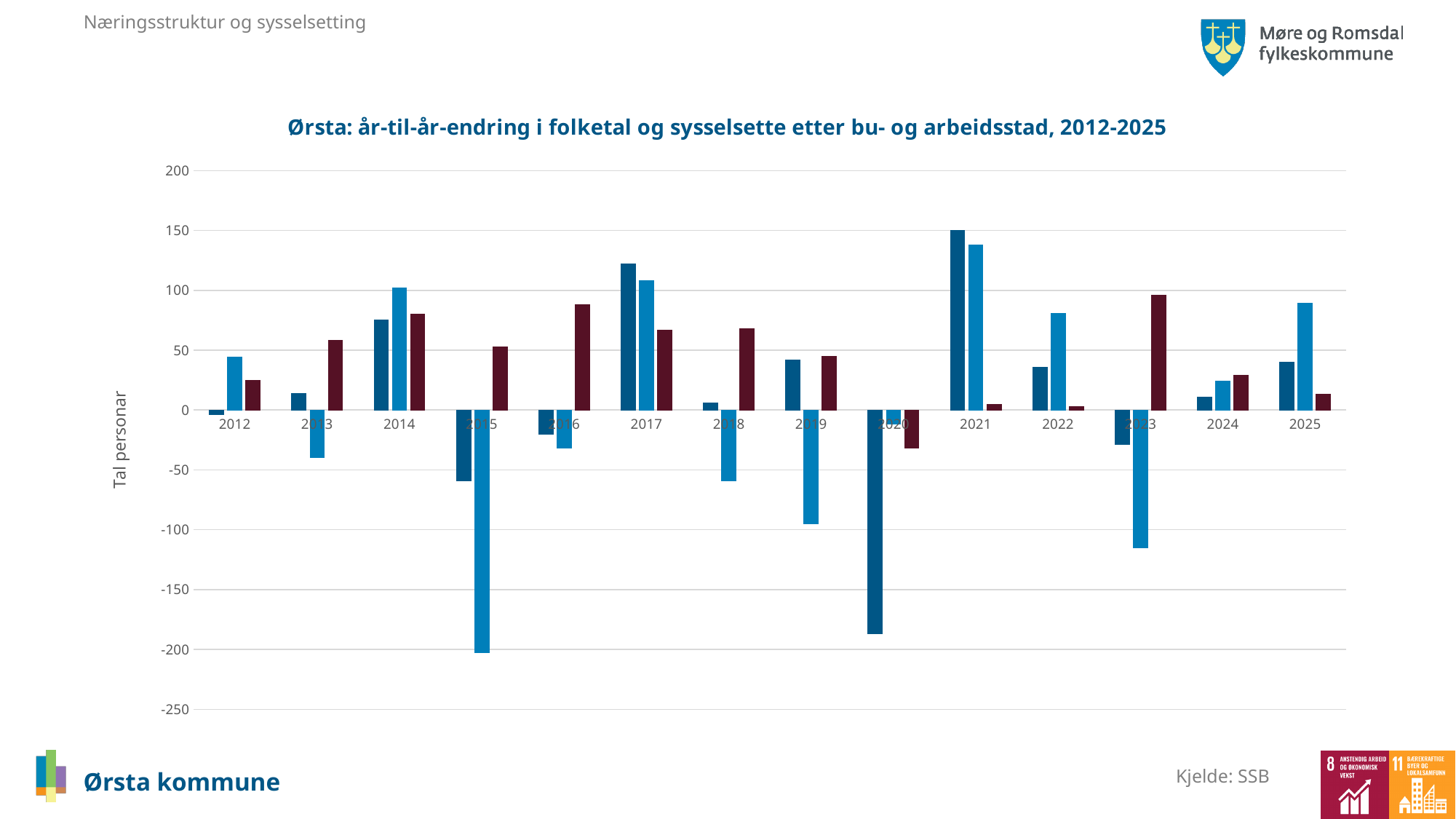
Which is larger: the dark blue bar for 2017 or the dark blue bar for 2021? 2021 Is the value of the light blue bar for 2015 greater or less than -150? less Is the value of the light blue bar for 2023 greater or less than -100? less Is the value of the dark blue bar for 2020 greater or less than -150? less What is the label on the vertical axis of the chart? Tal personar What is the title of the chart? Ørsta: år-til-år-endring i folketal og sysselsette etter bu- og arbeidsstad, 2012-2025 How many years are shown on the x axis of the chart? 14 In which year is the dark blue bar highest? 2021 What kind of chart is shown on the slide? bar chart In which year is the light blue bar lowest? 2015